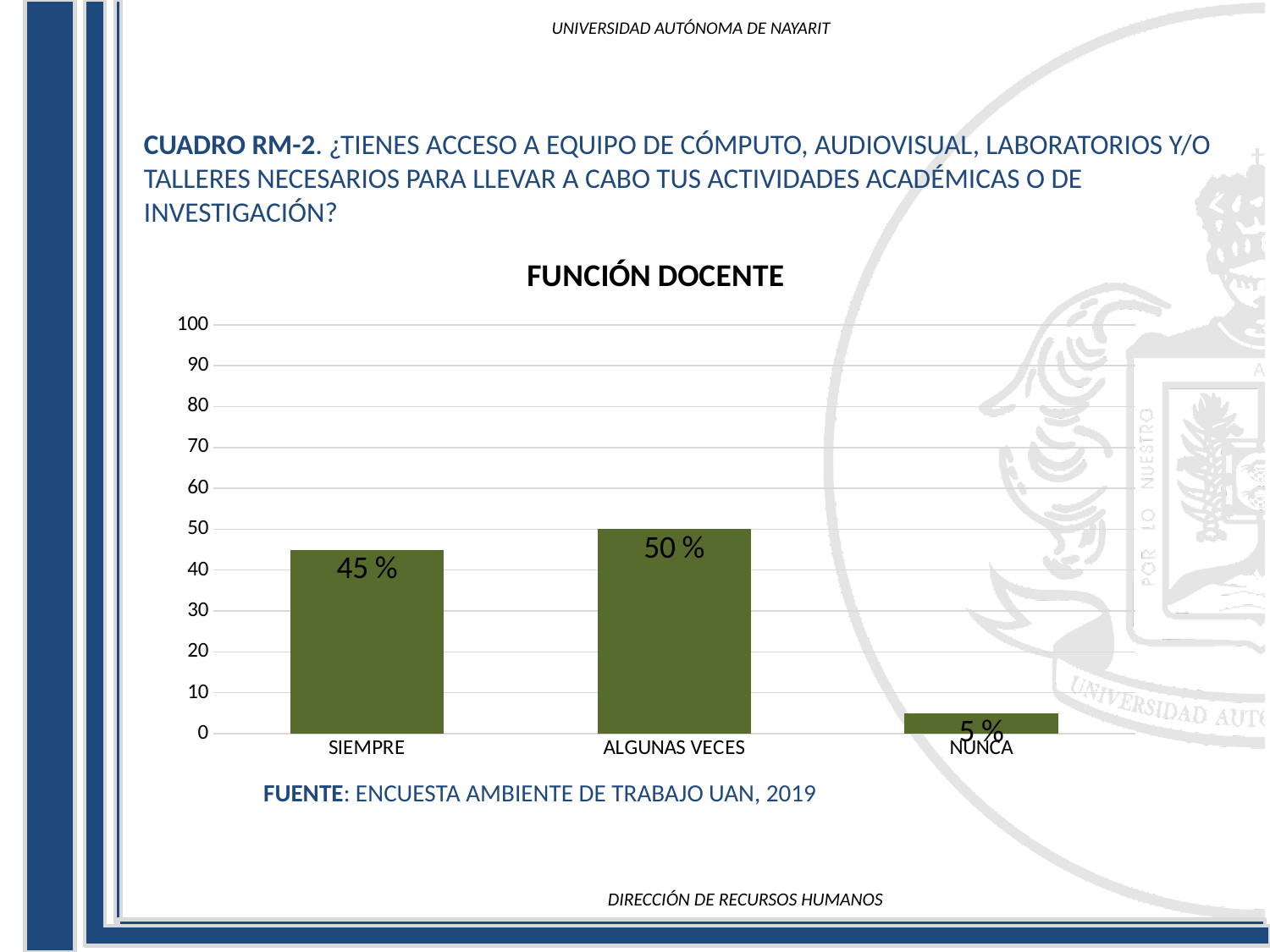
Is the value for ALGUNAS VECES greater or less than 40? greater How many categories are shown on the x axis? 3 What is the difference between the values for SIEMPRE and NUNCA? 40 % What is the title of the chart? FUNCIÓN DOCENTE What is the value for NUNCA? 5 % What is the value for ALGUNAS VECES? 50 % Which is larger, the value for SIEMPRE or the value for NUNCA? SIEMPRE What is the value for SIEMPRE? 45 % Which category has the lowest value? NUNCA What is the difference between the values for ALGUNAS VECES and SIEMPRE? 5 % Which category has the highest value? ALGUNAS VECES What kind of chart is shown on the slide? bar chart